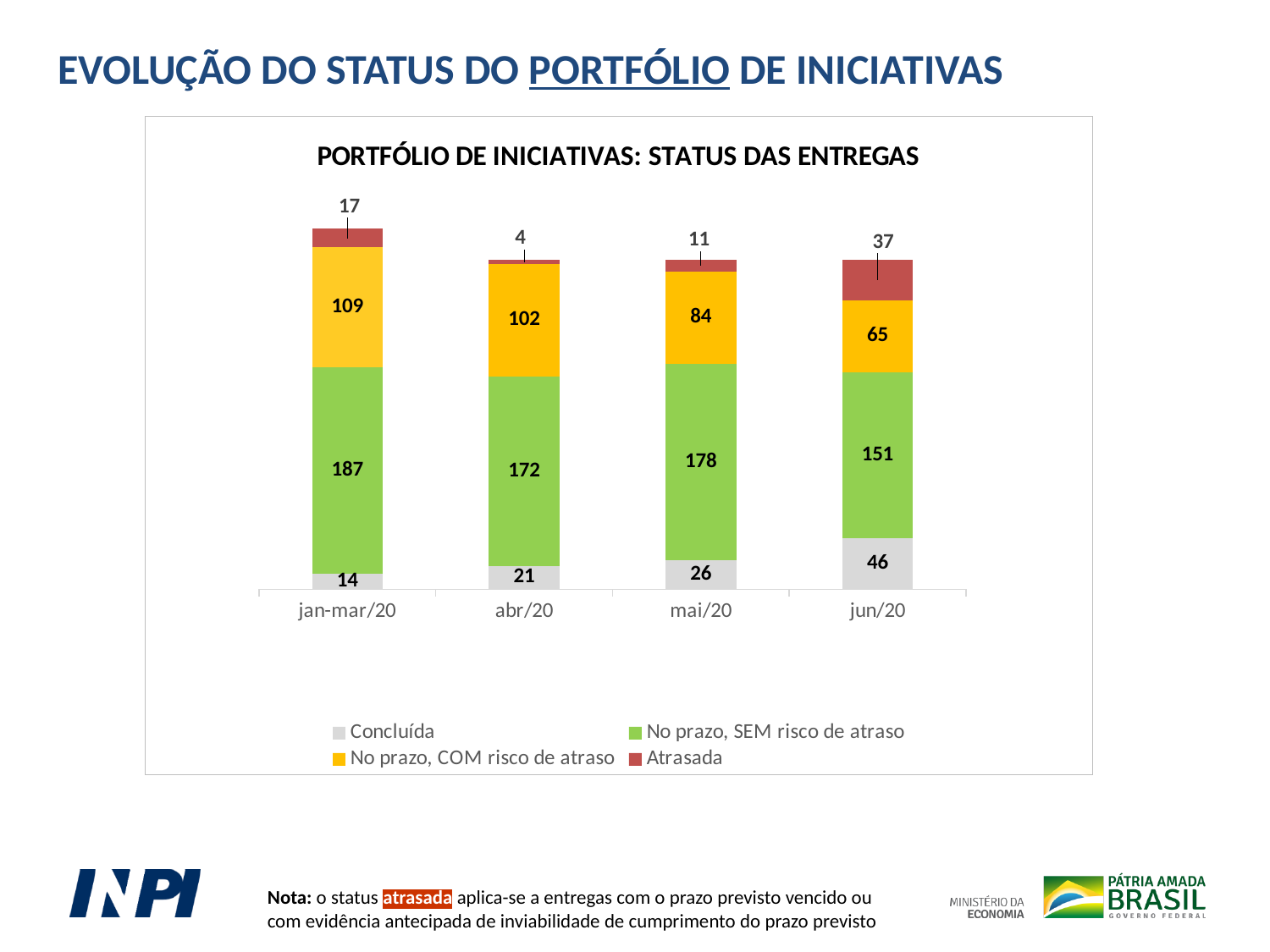
What is the total of the stacked bar for jan-mar/20? 327 What is the value of 'Atrasada' for jun/20? 37 Does the 'No prazo, COM risco de atraso' value rise or fall from jan-mar/20 to jun/20? Fall What type of chart is shown on the slide? Stacked bar chart In which period is the 'Concluída' value highest? jun/20 Which is larger: 'No prazo, SEM risco de atraso' in abr/20 or in mai/20? mai/20 What is the value of 'Concluída' for abr/20? 21 How many series does the legend list? 4 In which period is the 'Atrasada' value lowest? abr/20 What is the difference between the 'No prazo, COM risco de atraso' values for jan-mar/20 and jun/20? 44 How many periods are shown on the x axis of the chart? 4 What is the value of 'No prazo, SEM risco de atraso' for mai/20? 178